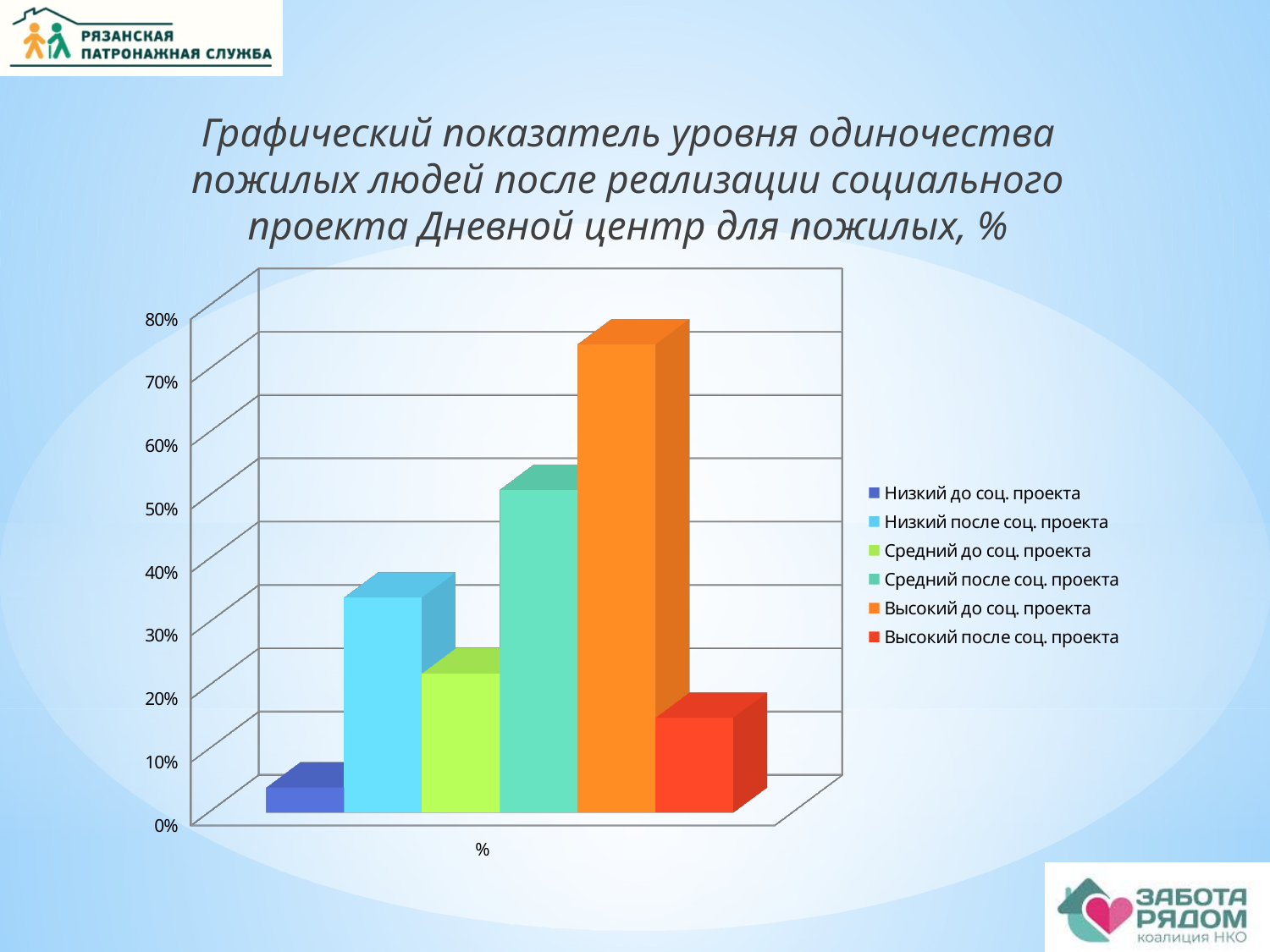
Is the value for Низкий до соц. проекта greater or less than 10%? less What colour is the bar for Высокий до соц. проекта? orange Which series has the highest bar? Высокий до соц. проекта What kind of chart is shown on the slide? bar chart Which is larger, the value for Средний после соц. проекта or the value for Высокий после соц. проекта? Средний после соц. проекта Which is larger, the value for Низкий после соц. проекта or the value for Средний до соц. проекта? Низкий после соц. проекта Which series has the lowest bar? Низкий до соц. проекта How many series does the legend list? 6 Is the value for Высокий после соц. проекта greater or less than 20%? less Is the value for Низкий после соц. проекта greater or less than 30%? greater